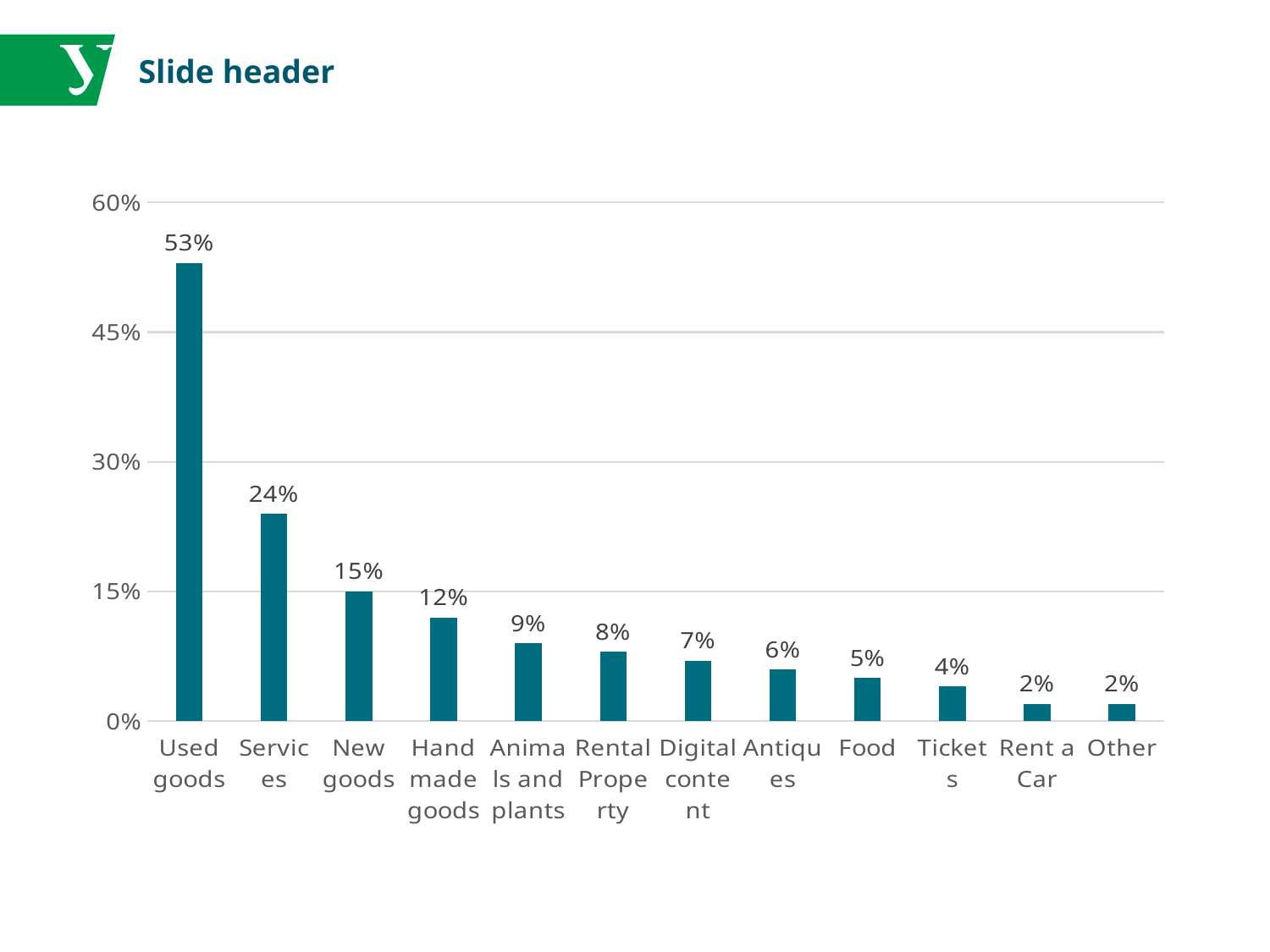
How many categories are shown on the x axis? 12 Which is larger, the value for Animals and plants or the value for Antiques? Animals and plants Do the values rise or fall from left to right along the x axis? Fall Is the value for Services greater or less than 30%? less What is the value for Services? 24% What is the value for Handmade goods? 12% Which category has the highest value? Used goods What is the difference between the values for New goods and Food? 10% What is the difference between the values for Used goods and Services? 29% What kind of chart is shown on the slide? Bar chart What is the value for Digital content? 7% What is the value for Used goods? 53%